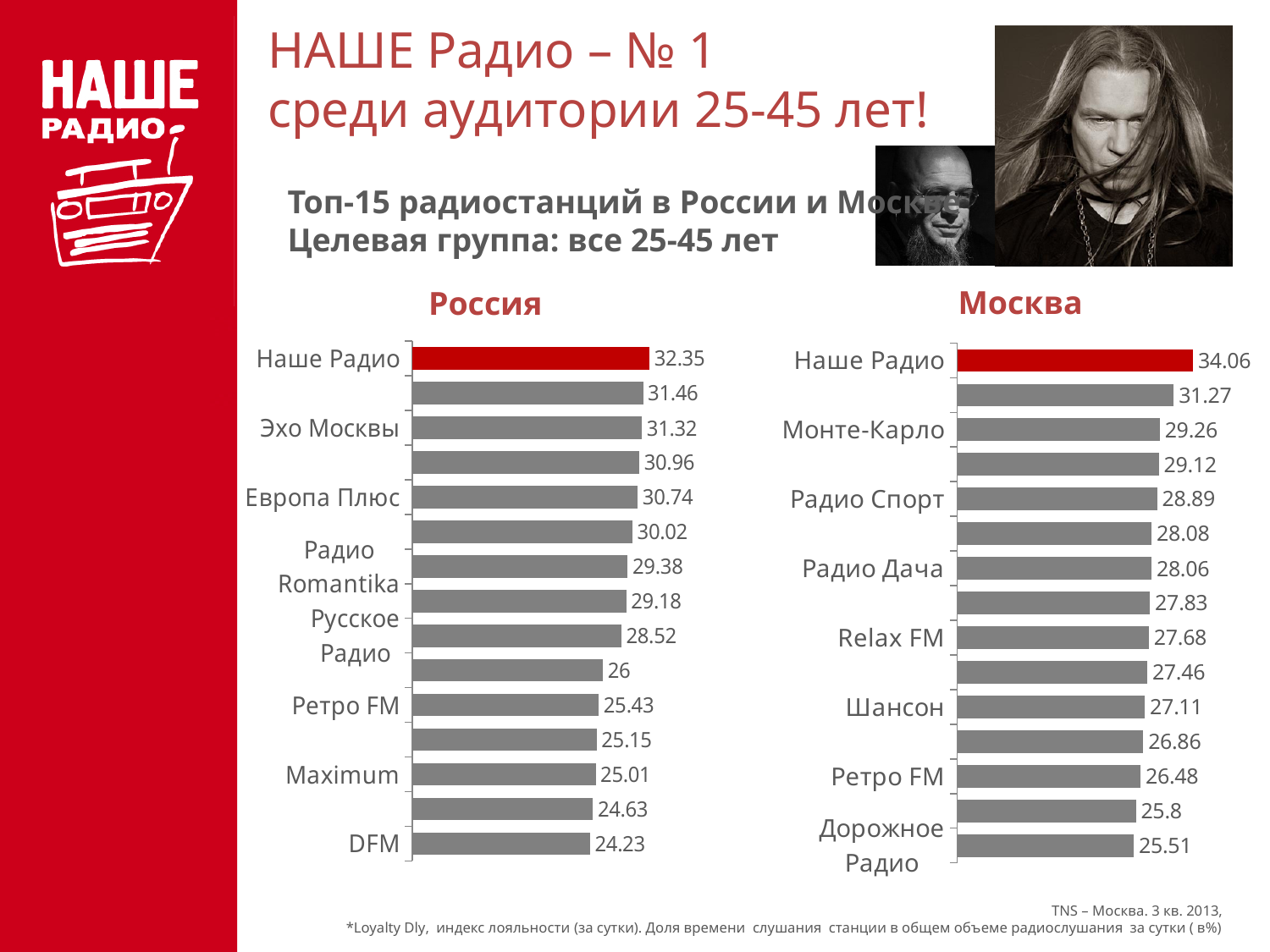
In the Россия chart, which station has the highest value? Наше Радио In the Москва chart, which labelled station has the lowest value? Дорожное Радио How many bars does the Москва chart contain? 15 In the Россия chart, what is the value for Наше Радио? 32.35 In the Москва chart, what is the value for Наше Радио? 34.06 In the Москва chart, what colour is the bar for Наше Радио? Red In the Россия chart, what is the value for DFM? 24.23 In the Москва chart, what is the value for Монте-Карло? 29.26 In the Россия chart, which is larger: the value for Эхо Москвы or the value for Европа Плюс? Эхо Москвы What is the difference between the Наше Радио values in the Москва chart and the Россия chart? 1.71 What type of chart is used for the Россия data? Bar chart In the Москва chart, what is the value for Дорожное Радио? 25.51